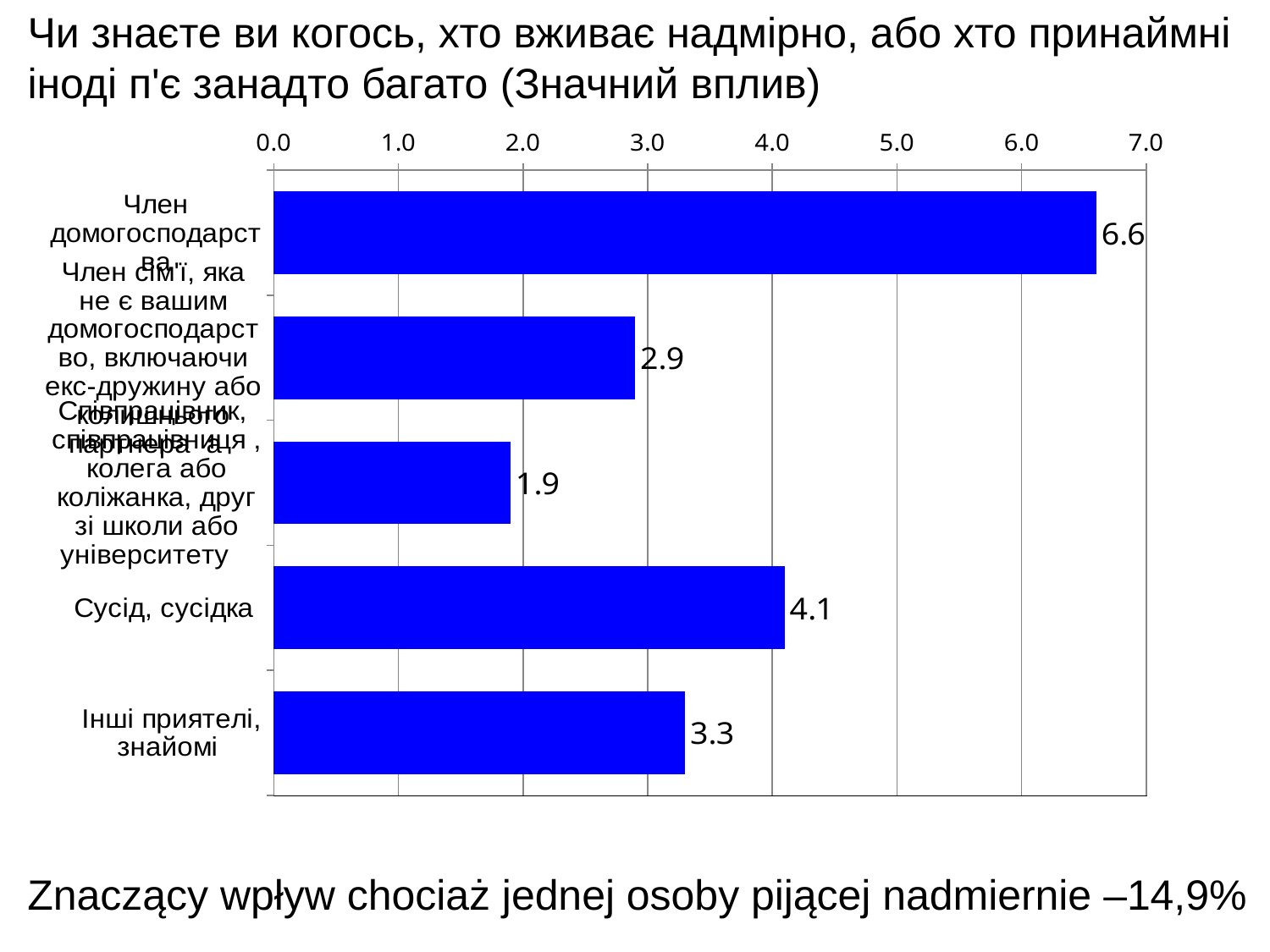
What is the value for "Член домогосподарства"? 6.6 What is the value for the category about a co-worker, colleague or friend from school or university ("Співпрацівник, співпрацівниця, колега або коліжанка...")? 1.9 What is the maximum value shown on the chart's value axis? 7.0 Which category has the highest value? Член домогосподарства What kind of chart is shown on the slide? bar chart Is the value for "Член домогосподарства" greater or less than 6.0? greater Which is larger: the value for "Сусід, сусідка" or the value for "Інші приятелі, знайомі"? Сусід, сусідка What is the value for "Сусід, сусідка"? 4.1 What is the difference between the values for "Член домогосподарства" and "Сусід, сусідка"? 2.5 Which category has the lowest value? Співпрацівник, співпрацівниця, колега або коліжанка, друг зі школи або університету How many categories are shown in the chart? 5 What is the value for "Інші приятелі, знайомі"? 3.3